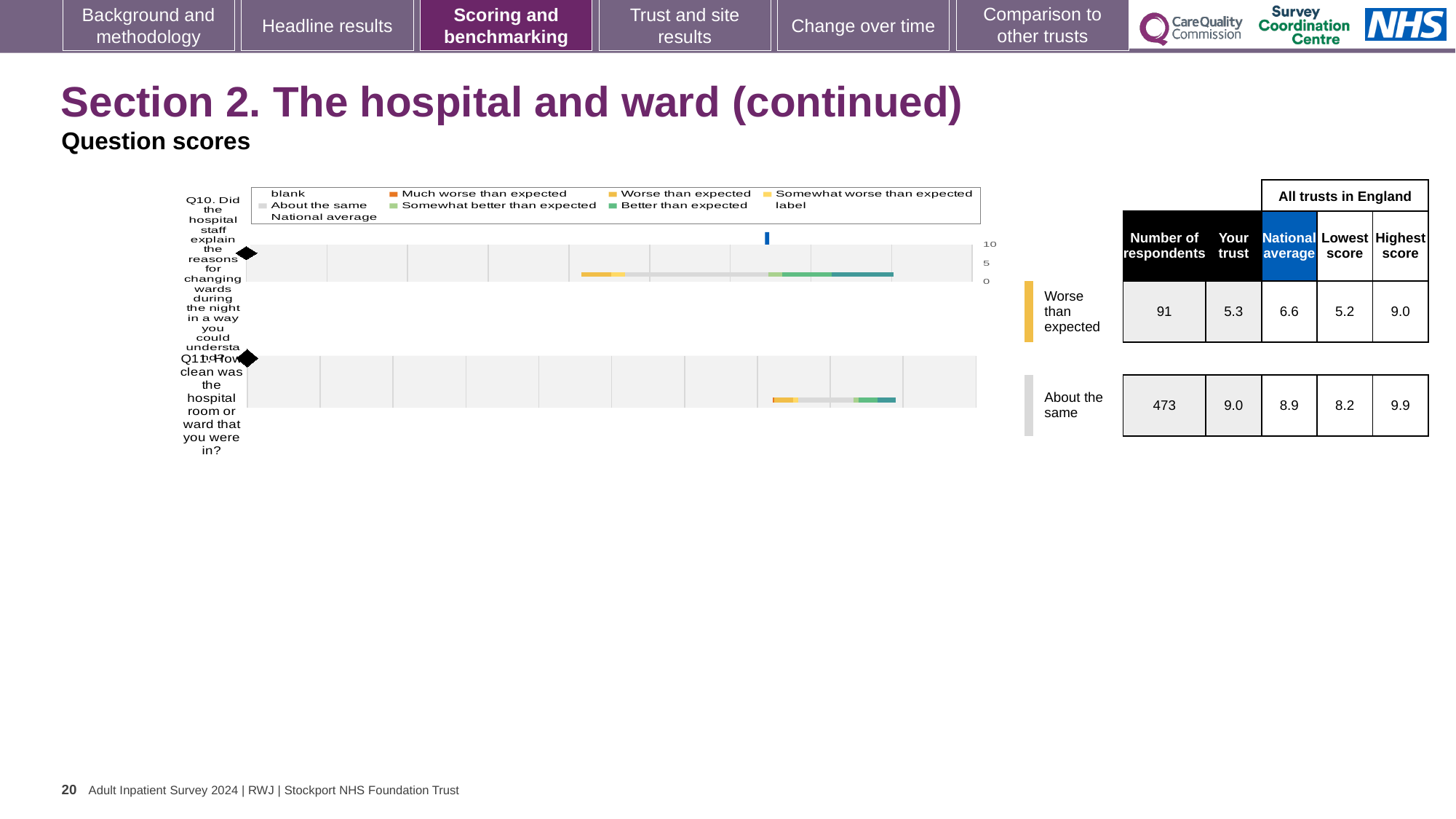
What kind of chart is shown on the slide? bar chart What is the 'Your trust' score for Q10 (explaining reasons for changing wards during the night)? 5.3 How many questions are plotted in the chart? 2 For Q10, which is larger: the trust's score or the national average? National average Is the trust's score marker for Q11 greater or less than 5 on the axis? greater What is the difference between the national average and the trust's score for Q10? 1.3 Which of the two questions has the higher 'Your trust' score? Q11 What benchmark category is Q10 assigned to? Worse than expected What is the national average score for Q10? 6.6 How many respondents answered Q11? 473 What is the 'Your trust' score for Q11 (how clean was the hospital room or ward)? 9.0 What is the difference between the highest score and the lowest score for Q11? 1.7